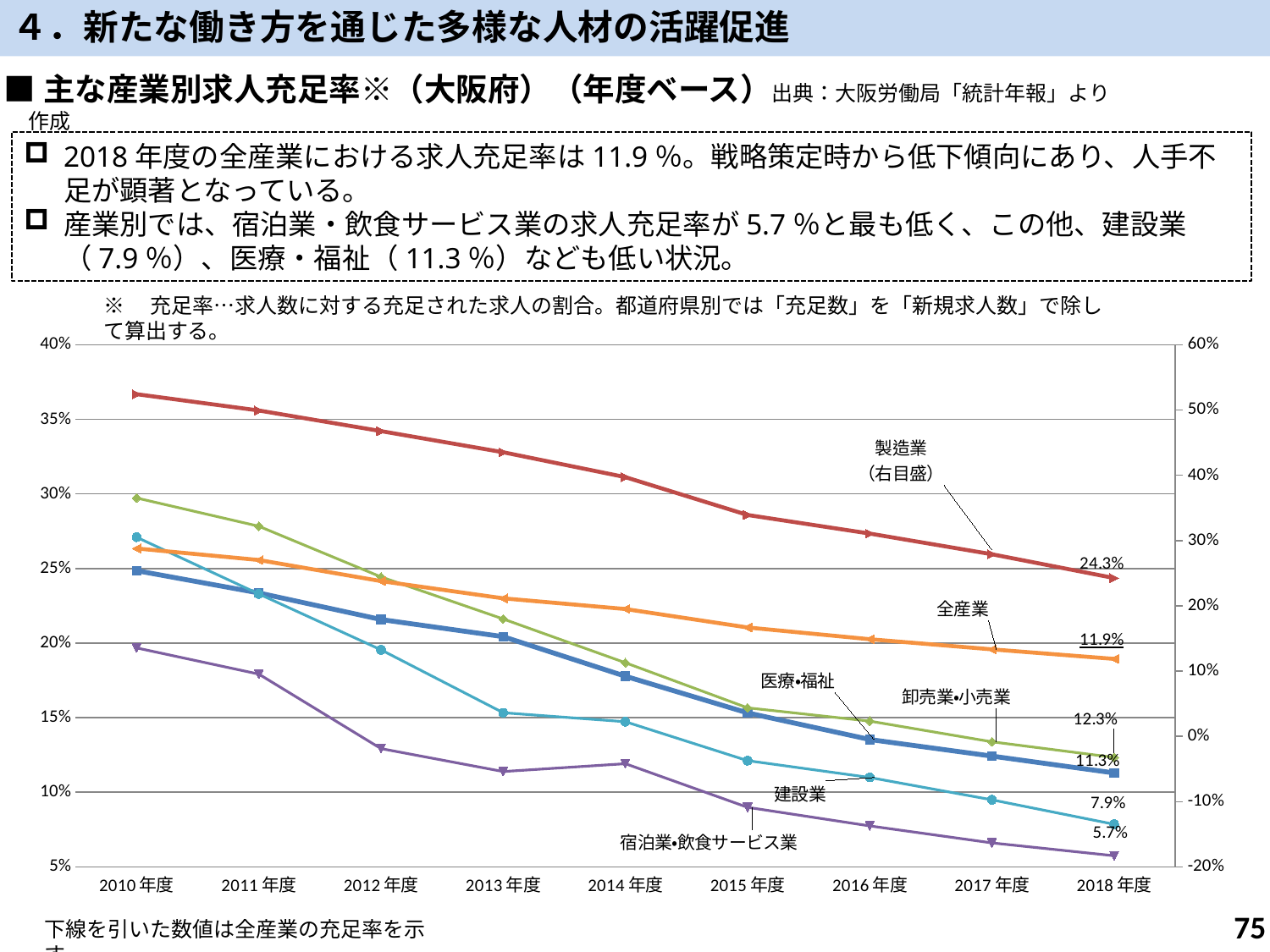
Which series is plotted against the right-hand axis? 製造業 What is the value for 建設業 in 2018年度? 7.9% In 2018年度, which is larger: 卸売業・小売業 or 医療・福祉? 卸売業・小売業 How many fiscal years are plotted on the x axis? 9 What is the value for 宿泊業・飲食サービス業 in 2018年度? 5.7% What is the difference between 全産業 (11.9%) and 宿泊業・飲食サービス業 (5.7%) in 2018年度? 6.2 percentage points What is the value for 製造業 in 2018年度? 24.3% What is the value for 全産業 in 2018年度? 11.9% What is the value for 医療・福祉 in 2018年度? 11.3% What kind of chart is shown on the slide? Line chart Does the 全産業 line rise or fall from 2010年度 to 2018年度? Fall Which industry has the lowest value in 2018年度? 宿泊業・飲食サービス業